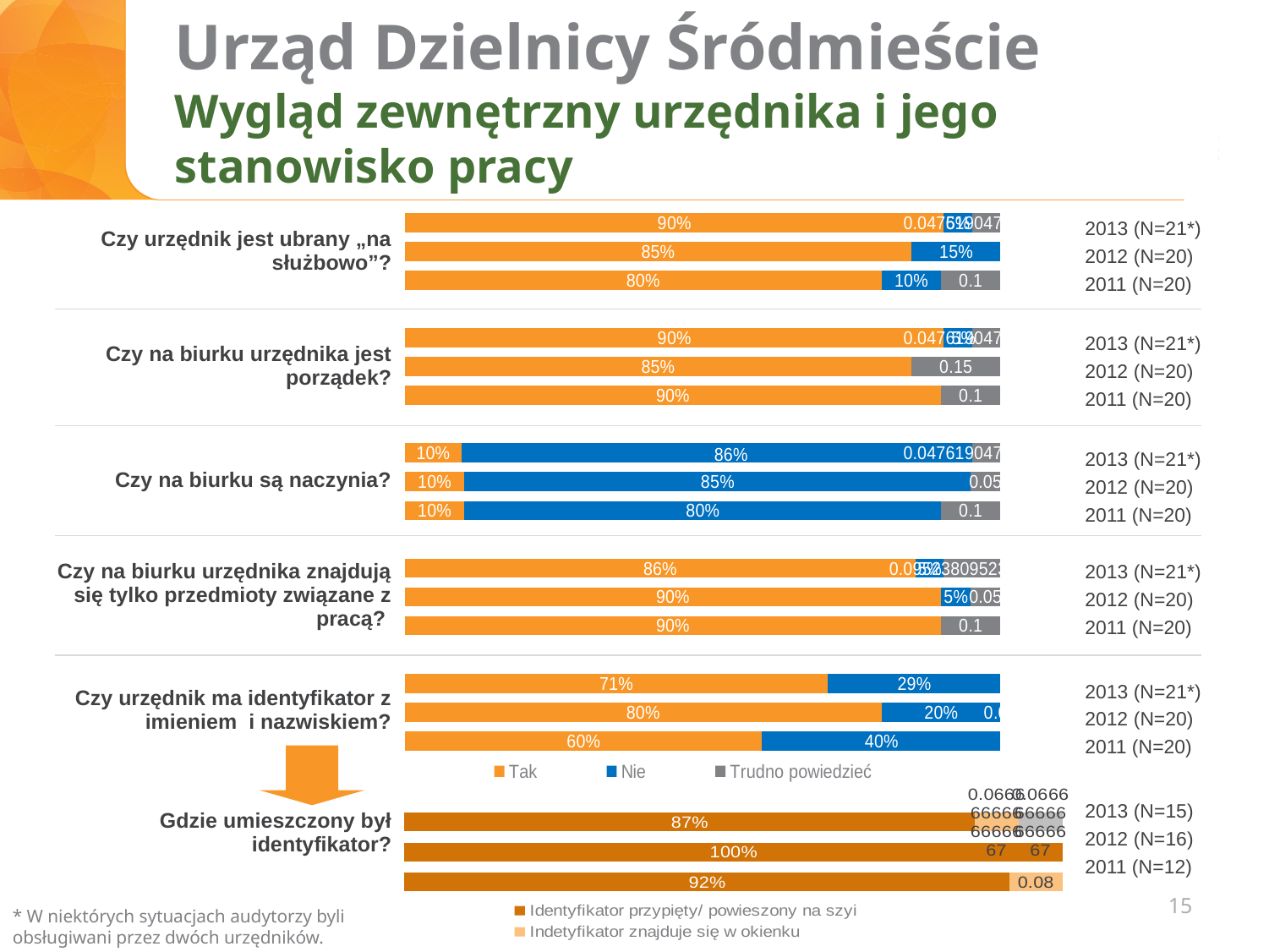
In the chart "Czy urzędnik ma identyfikator z imieniem i nazwiskiem?", what is the difference between the "Nie" values for 2011 and 2012? 20% How many series does the legend with "Tak", "Nie" and "Trudno powiedzieć" list? 3 In the chart "Czy urzędnik ma identyfikator z imieniem i nazwiskiem?", what is the "Tak" value for 2011 (N=20)? 60% In the chart "Czy na biurku są naczynia?", what is the "Nie" value for 2013 (N=21*)? 86% What kind of chart is used for "Czy na biurku są naczynia?"? Stacked bar chart In the chart "Czy urzędnik ma identyfikator z imieniem i nazwiskiem?", is the "Tak" value larger for 2013 or for 2012? 2012 In the chart "Gdzie umieszczony był identyfikator?", what is the value for "Identyfikator przypięty/ powieszony na szyi" in 2012 (N=16)? 100% In the chart "Czy na biurku są naczynia?", which year has the lowest "Nie" value? 2011 (N=20) In the chart "Gdzie umieszczony był identyfikator?", what is the value for "Identyfikator przypięty/ powieszony na szyi" in 2013 (N=15)? 87% In the chart "Czy urzędnik ma identyfikator z imieniem i nazwiskiem?", which year has the highest "Tak" value? 2012 (N=20) In the chart "Czy urzędnik jest ubrany „na służbowo”?", what is the "Nie" value for 2011 (N=20)? 10% In the chart "Czy urzędnik jest ubrany „na służbowo”?", what is the "Tak" value for 2012 (N=20)? 85%